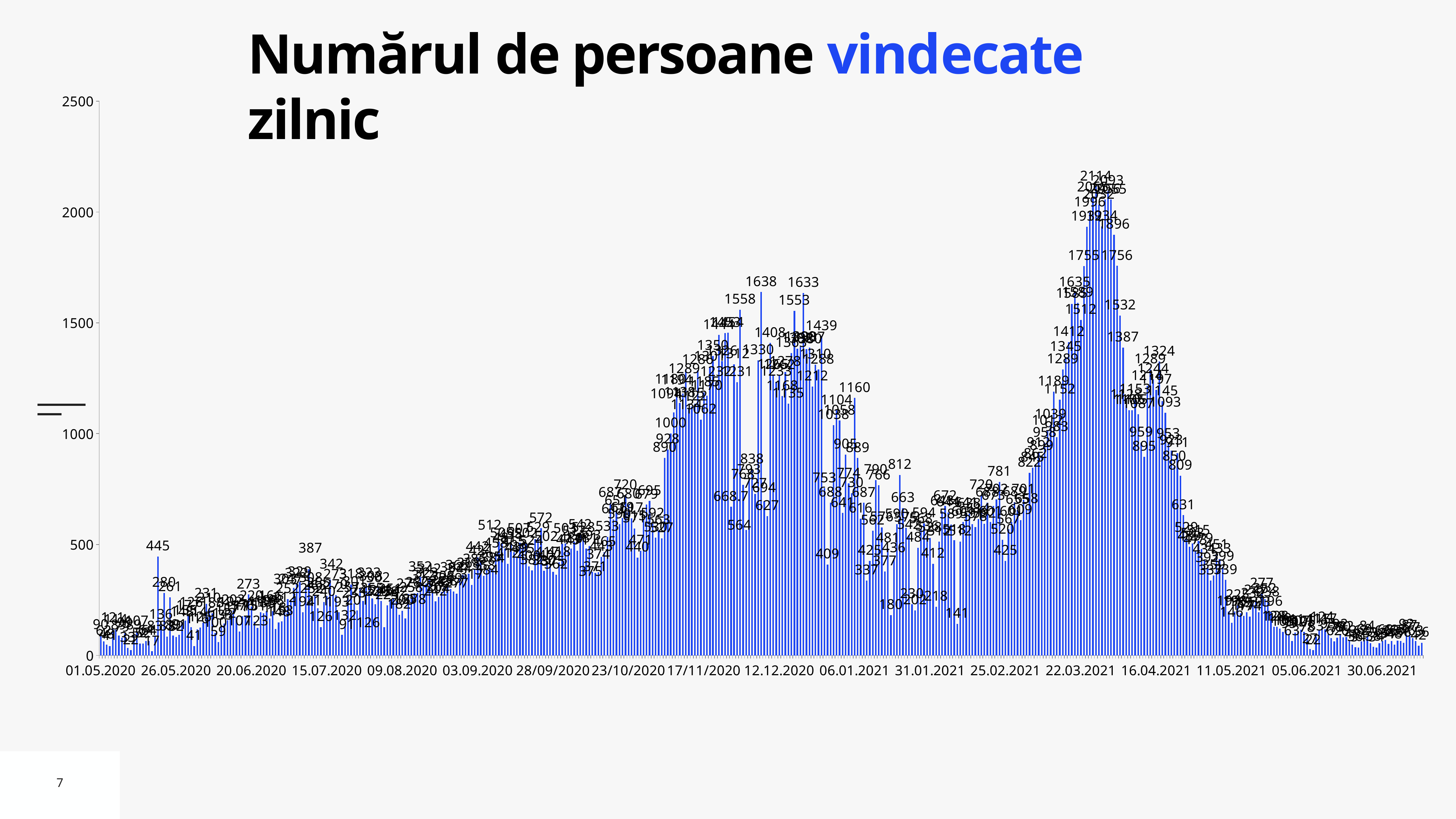
What kind of chart is shown on the slide? bar chart What is the difference between the peak value 2114 and the peak value 1638? 476 What is the highest value labelled on the chart? 2114 What is the highest value shown on the vertical axis? 2500 Is the bar labelled 445 near 26.05.2020 greater or less than 500? less What is the title of the chart? Numărul de persoane vindecate zilnic How many date labels are shown on the horizontal axis? 18 Do the values rise or fall between 25.02.2021 and 22.03.2021? rise Do the values rise or fall between 22.03.2021 and 30.06.2021? fall Is the value labelled 141 near 31.01.2021 greater or less than 500? less Is the peak value reached around 22.03.2021 greater or less than 2000? greater Which is larger: the peak labelled 1638 around 12.12.2020 or the peak labelled 2114 around 22.03.2021? 2114 around 22.03.2021